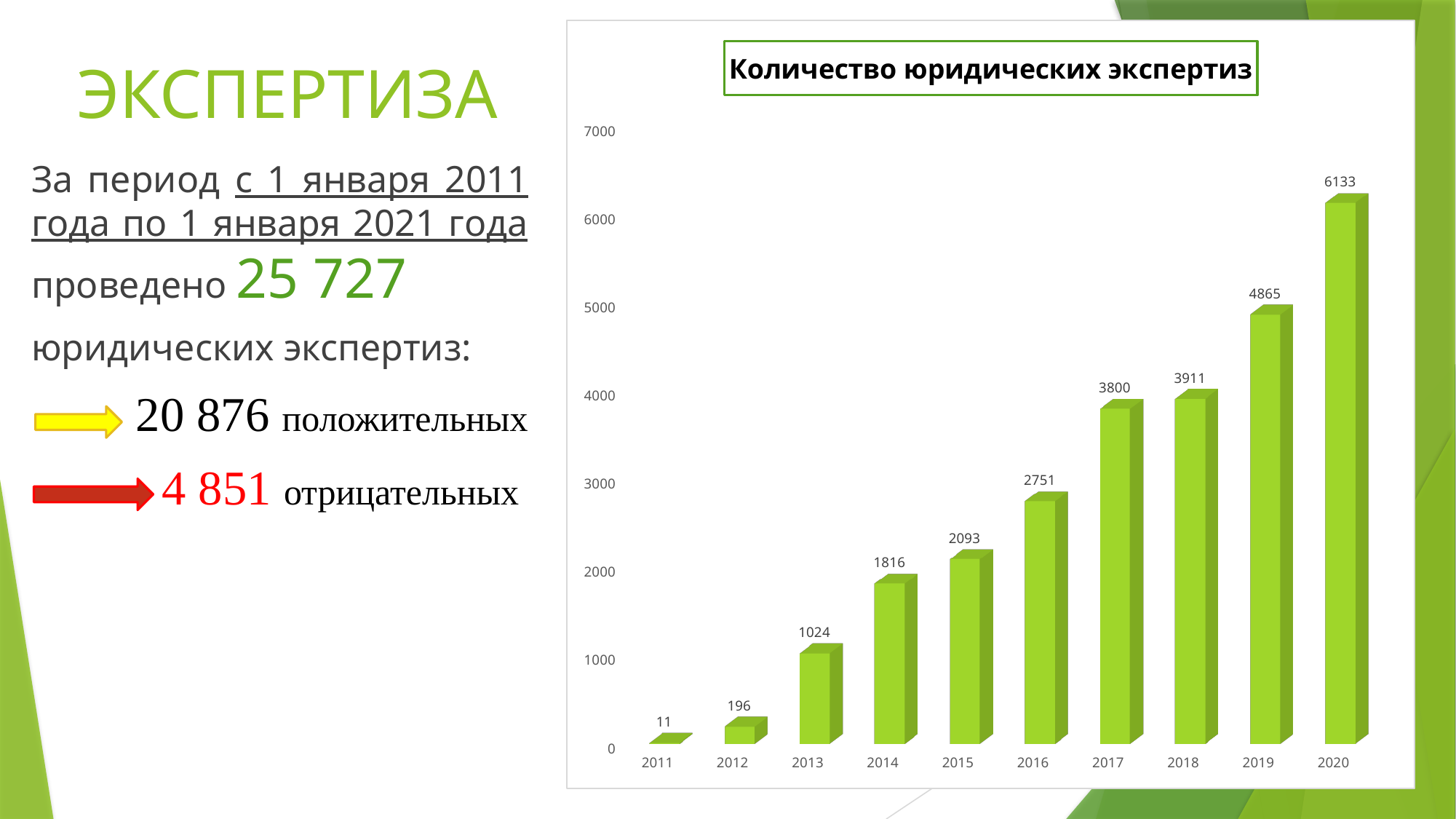
What is the difference between the values for 2018 and 2017? 111 What kind of chart is shown on the slide? bar chart What is the title of the chart? Количество юридических экспертиз What is the value for 2013 in the chart? 1024 Which is larger, the value for 2015 or the value for 2014? 2015 Do the values rise or fall from 2011 to 2020? rise Is the value for 2019 greater or less than 4000? greater How many years are shown on the x axis of the chart? 10 Which year has the highest value in the chart? 2020 Which year has the lowest value in the chart? 2011 What is the value for 2016 in the chart? 2751 What is the difference between the values for 2020 and 2019? 1268